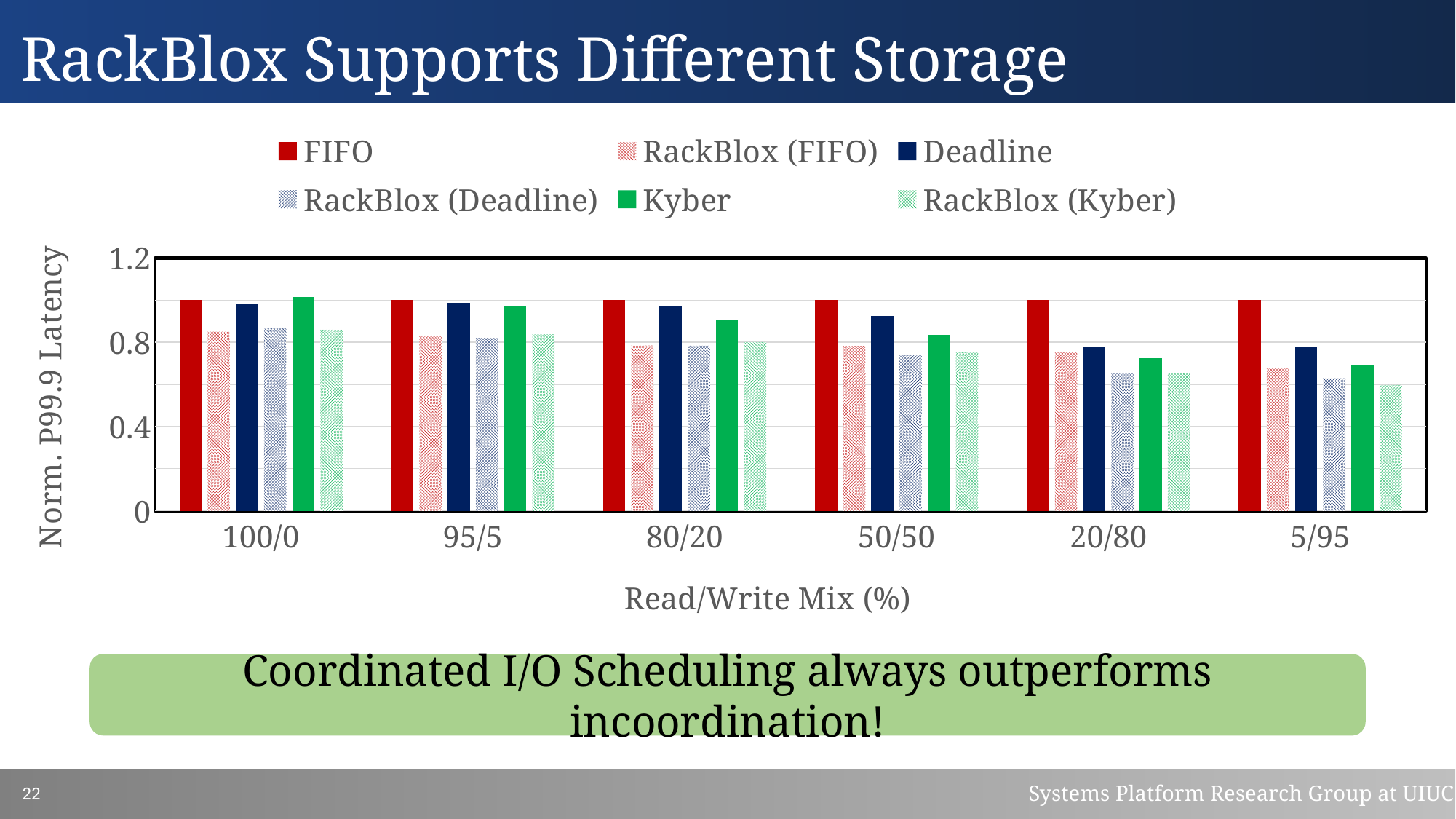
How many series does the legend list? 6 Do the values for RackBlox (Kyber) rise or fall from 100/0 to 5/95? fall Is the value for FIFO at 100/0 greater or less than 0.8? greater How many read/write mix categories are shown on the x axis? 6 What kind of chart is shown on the slide? bar chart Which series has the highest value at 5/95? FIFO At 50/50, which is larger: Deadline or RackBlox (Deadline)? Deadline Is the value for RackBlox (Kyber) at 5/95 greater or less than 0.8? less What is the label of the x axis? Read/Write Mix (%) What is the label of the y axis? Norm. P99.9 Latency Is the value for Kyber at 100/0 greater or less than 0.8? greater